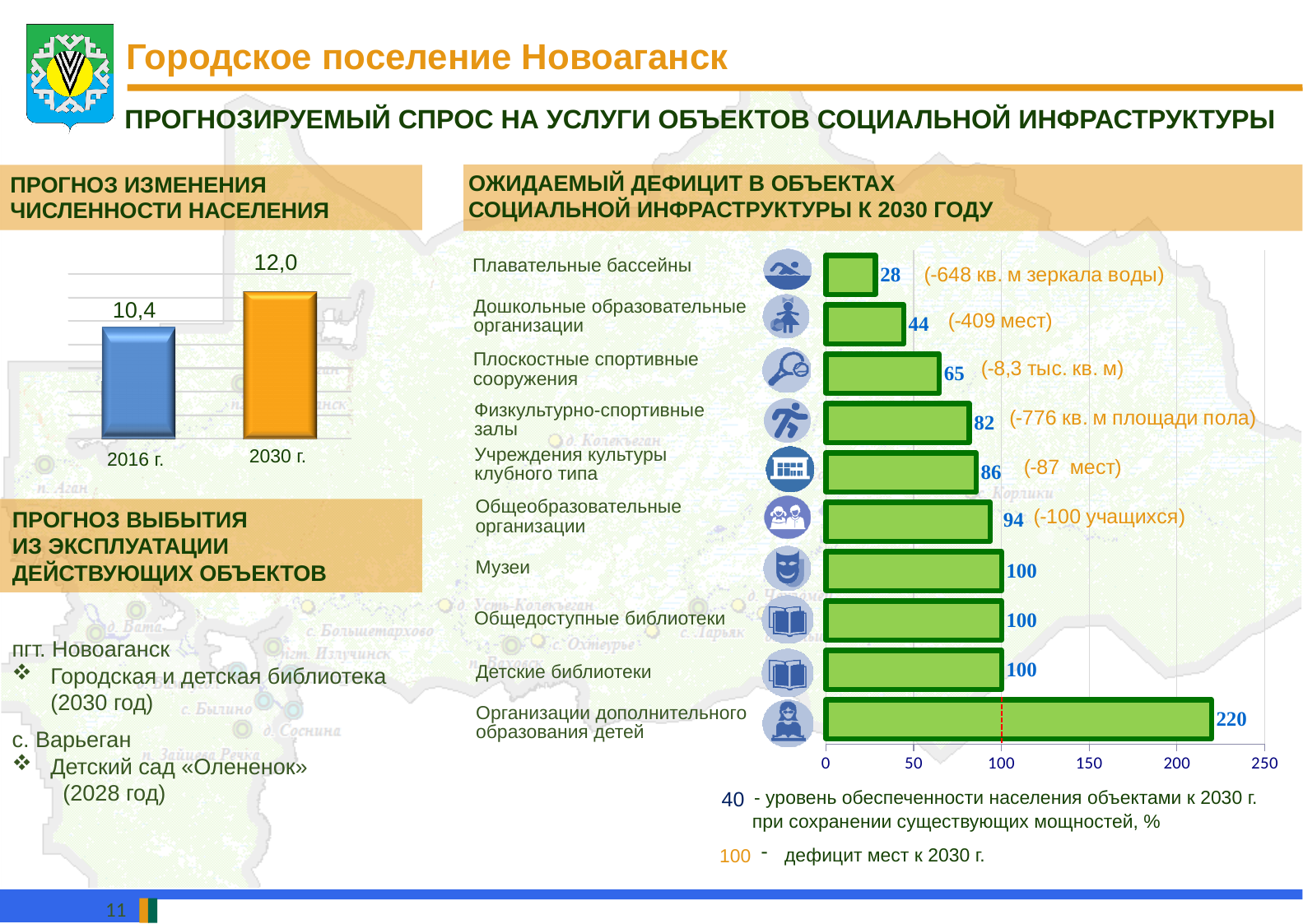
In the chart 'ОЖИДАЕМЫЙ ДЕФИЦИТ В ОБЪЕКТАХ СОЦИАЛЬНОЙ ИНФРАСТРУКТУРЫ К 2030 ГОДУ', how many categories are plotted? 10 In the chart 'ОЖИДАЕМЫЙ ДЕФИЦИТ В ОБЪЕКТАХ СОЦИАЛЬНОЙ ИНФРАСТРУКТУРЫ К 2030 ГОДУ', what is the value for Физкультурно-спортивные залы? 82 In the chart 'ОЖИДАЕМЫЙ ДЕФИЦИТ В ОБЪЕКТАХ СОЦИАЛЬНОЙ ИНФРАСТРУКТУРЫ К 2030 ГОДУ', what is the value for Плавательные бассейны? 28 In the chart 'ОЖИДАЕМЫЙ ДЕФИЦИТ В ОБЪЕКТАХ СОЦИАЛЬНОЙ ИНФРАСТРУКТУРЫ К 2030 ГОДУ', which is larger: the value for Плоскостные спортивные сооружения or the value for Учреждения культуры клубного типа? Учреждения культуры клубного типа In the chart 'ПРОГНОЗ ИЗМЕНЕНИЯ ЧИСЛЕННОСТИ НАСЕЛЕНИЯ', what is the value for 2030 г.? 12,0 In the chart 'ПРОГНОЗ ИЗМЕНЕНИЯ ЧИСЛЕННОСТИ НАСЕЛЕНИЯ', how many bars are plotted? 2 In the chart 'ПРОГНОЗ ИЗМЕНЕНИЯ ЧИСЛЕННОСТИ НАСЕЛЕНИЯ', do the values rise or fall from 2016 г. to 2030 г.? rise In the chart 'ПРОГНОЗ ИЗМЕНЕНИЯ ЧИСЛЕННОСТИ НАСЕЛЕНИЯ', what is the value for 2016 г.? 10,4 In the chart 'ОЖИДАЕМЫЙ ДЕФИЦИТ В ОБЪЕКТАХ СОЦИАЛЬНОЙ ИНФРАСТРУКТУРЫ К 2030 ГОДУ', what is the difference between the values for Общеобразовательные организации and Дошкольные образовательные организации? 50 What kind of chart is 'ОЖИДАЕМЫЙ ДЕФИЦИТ В ОБЪЕКТАХ СОЦИАЛЬНОЙ ИНФРАСТРУКТУРЫ К 2030 ГОДУ'? bar chart In the chart 'ОЖИДАЕМЫЙ ДЕФИЦИТ В ОБЪЕКТАХ СОЦИАЛЬНОЙ ИНФРАСТРУКТУРЫ К 2030 ГОДУ', which category has the lowest value? Плавательные бассейны In the chart 'ОЖИДАЕМЫЙ ДЕФИЦИТ В ОБЪЕКТАХ СОЦИАЛЬНОЙ ИНФРАСТРУКТУРЫ К 2030 ГОДУ', which category has the highest value? Организации дополнительного образования детей